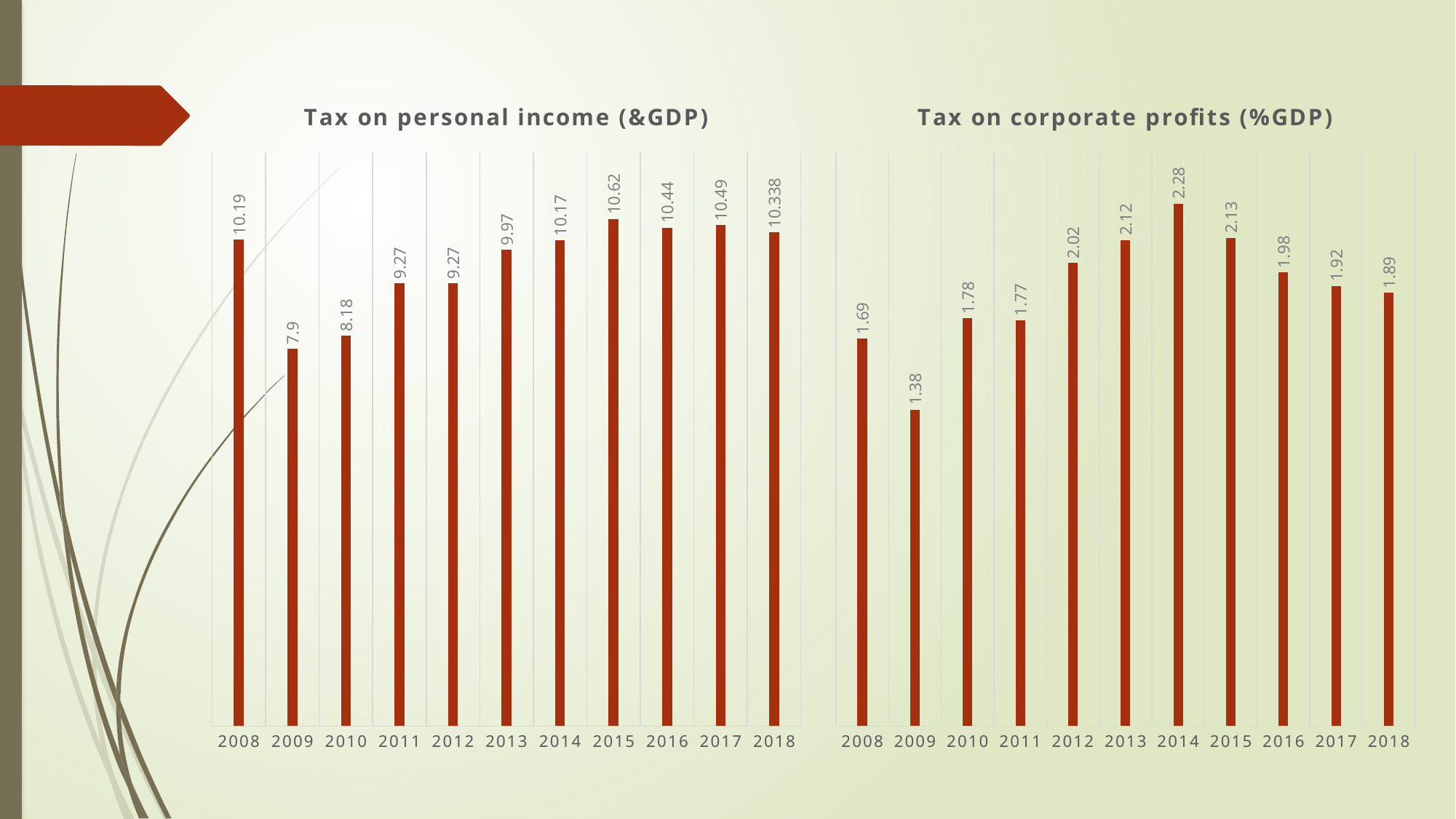
What is the title of the chart on the left side of the slide? Tax on personal income (&GDP) In the 'Tax on corporate profits (%GDP)' chart, which is larger, the value for 2012 or the value for 2010? 2012 In the 'Tax on corporate profits (%GDP)' chart, do the values rise or fall from 2014 to 2018? Fall How many years are shown in the 'Tax on personal income (&GDP)' chart? 11 In the 'Tax on personal income (&GDP)' chart, what is the difference between the values for 2008 and 2009? 2.29 In the 'Tax on personal income (&GDP)' chart, which year has the highest value? 2015 In the 'Tax on corporate profits (%GDP)' chart, which year has the lowest value? 2009 What kind of chart is the 'Tax on corporate profits (%GDP)' chart? Bar chart In the 'Tax on corporate profits (%GDP)' chart, what is the value for 2014? 2.28 In the 'Tax on corporate profits (%GDP)' chart, what is the difference between the values for 2014 and 2009? 0.9 In the 'Tax on personal income (&GDP)' chart, what is the value for 2009? 7.9 In the 'Tax on personal income (&GDP)' chart, which is larger, the value for 2010 or the value for 2013? 2013